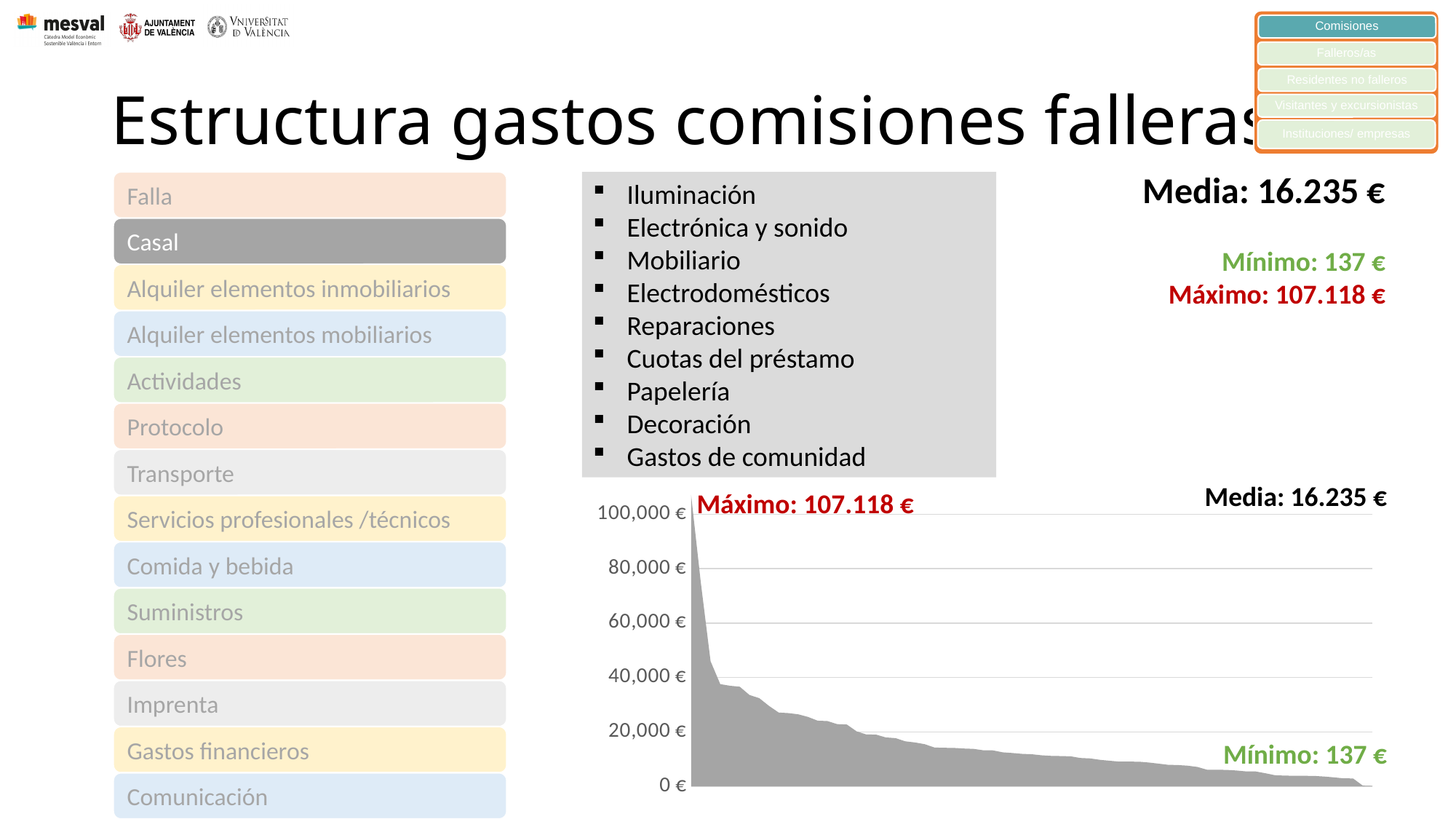
What is the maximum value annotated on the chart? 107.118 € What kind of chart is shown at the bottom right of the slide? area chart Which is larger, the annotated Media or the annotated Mínimo? Media Do the values in the chart rise or fall from left to right? fall Is the value of the first (leftmost) point in the chart greater or less than 100,000 €? greater Is the value of the last (rightmost) point in the chart greater or less than 20,000 €? less What is the minimum value annotated on the chart? 137 € What is the mean (Media) value annotated on the chart? 16.235 € What is the difference between the annotated maximum and minimum values? 106.981 € Which expense category in the left-hand list is highlighted as the one the chart refers to? Casal What is the highest tick label shown on the chart's vertical axis? 100,000 €